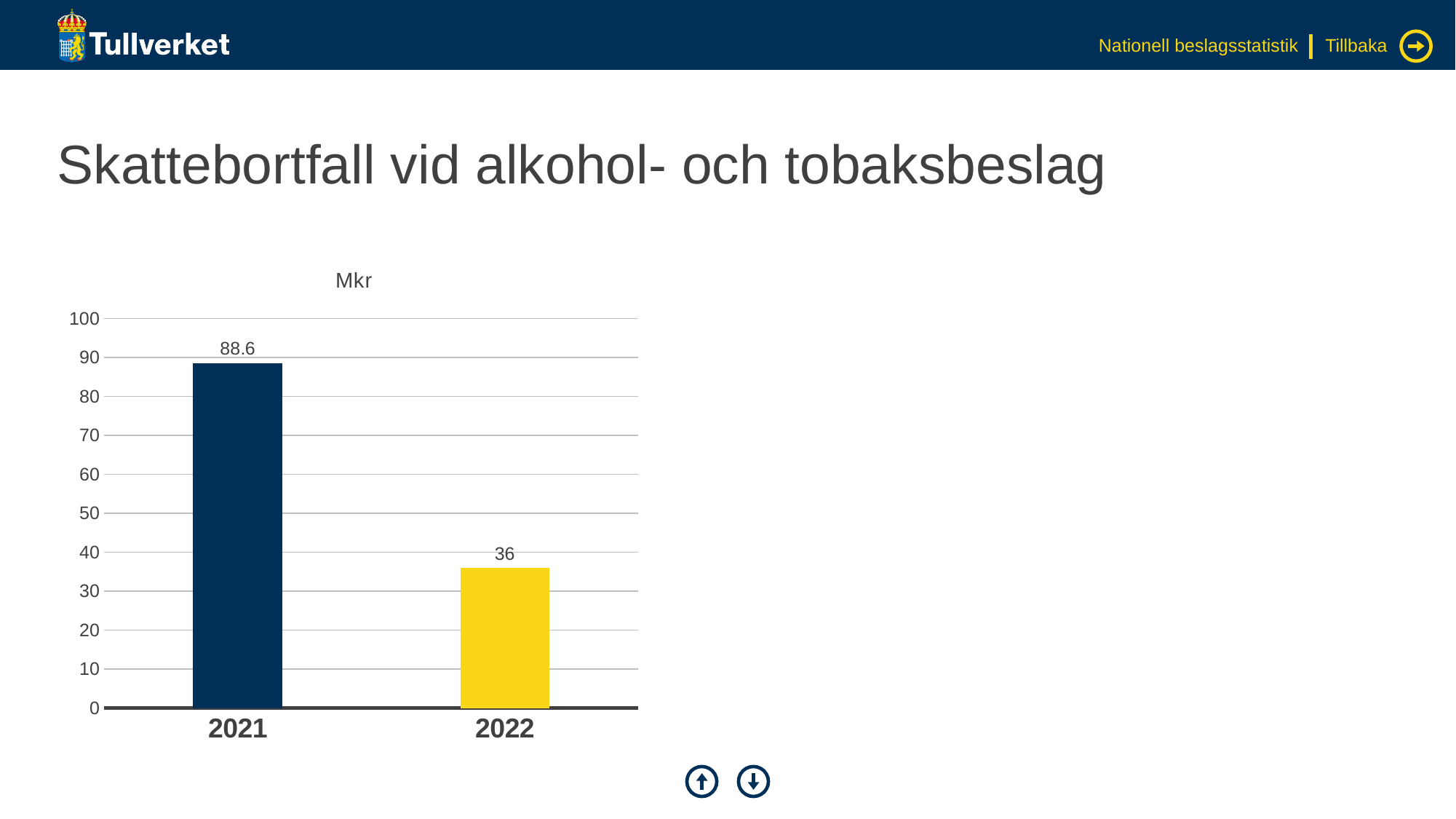
Is the value for 2021 greater or less than 80? greater How many years are shown on the chart? 2 What is the difference between the values for 2021 and 2022? 52.6 Which year has the lowest value? 2022 Which is larger, the value for 2021 or the value for 2022? 2021 Is the value for 2022 greater or less than 40? less What is the value for 2021? 88.6 Which year has the highest value? 2021 What kind of chart is shown on the slide? bar chart Do the values rise or fall from 2021 to 2022? fall What is the value for 2022? 36 What unit is shown above the chart's y axis? Mkr